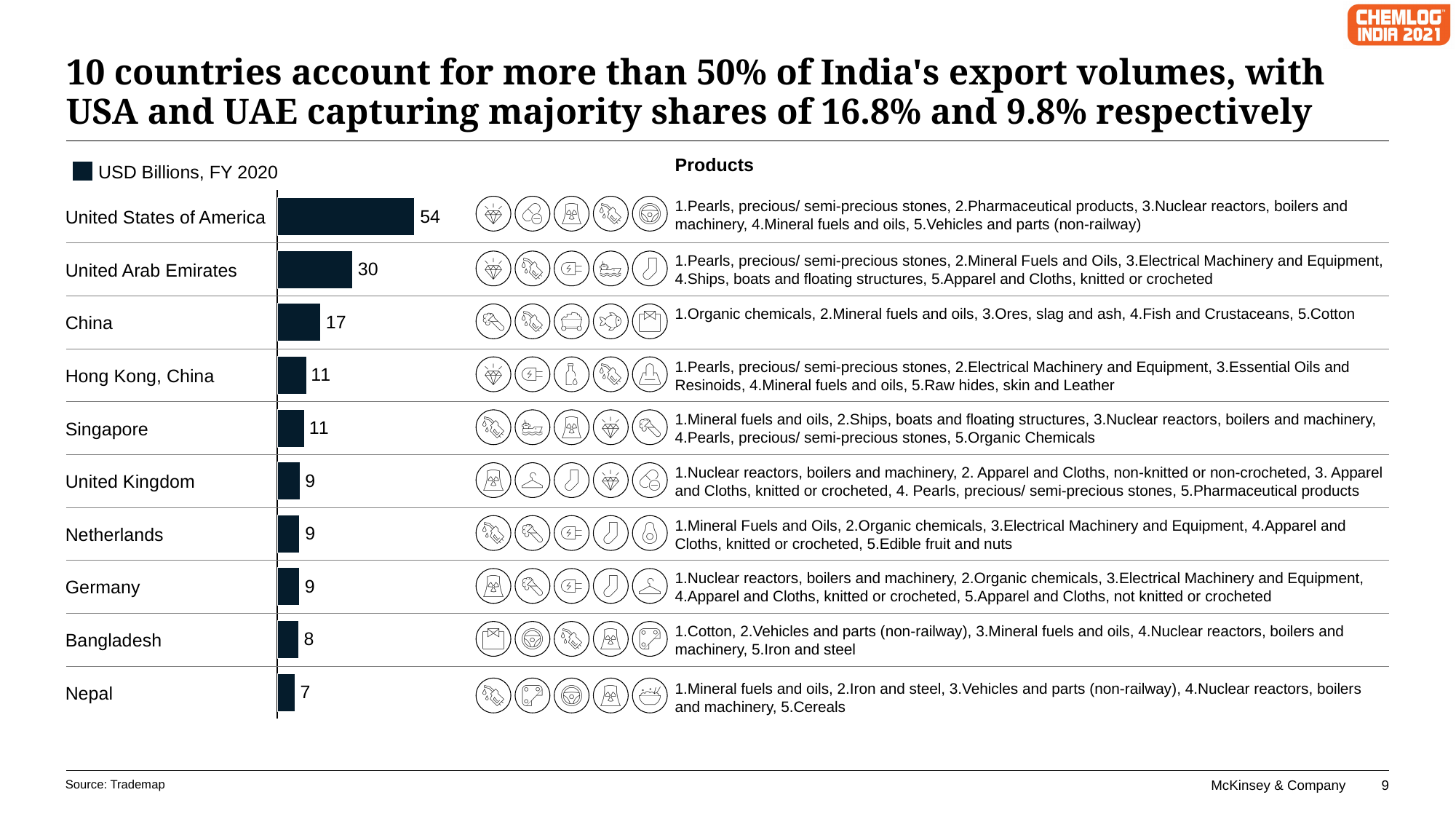
What is the export value for Nepal in USD billions? 7 What type of chart is used to show the export values? Bar chart What is the difference in export value between the United States of America and the United Arab Emirates? 24 What is the export value for the United Arab Emirates in USD billions? 30 Do the export values rise or fall going down the list of countries? Fall Which country has the highest export value? United States of America Which has a larger export value, China or Bangladesh? China What is the export value for China in USD billions? 17 What unit and period does the legend give for the bar values? USD Billions, FY 2020 Which country has the lowest export value? Nepal How many countries are shown in the bar chart? 10 What is the export value for the United States of America in USD billions? 54